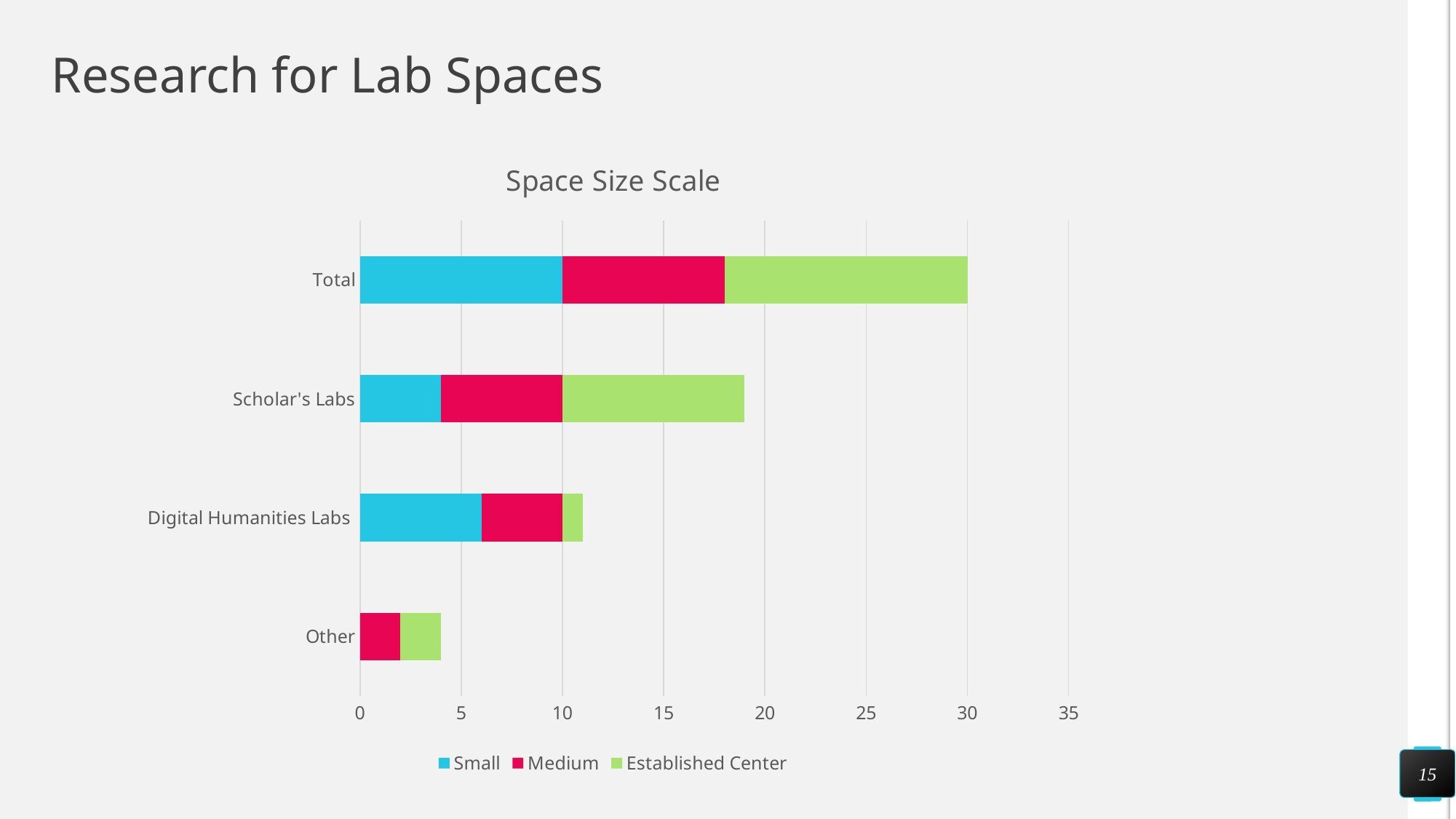
Which category has the shortest stacked bar? Other Which has a longer stacked bar, Scholar's Labs or Digital Humanities Labs? Scholar's Labs How many categories are shown on the chart? 4 What kind of chart is shown on the slide? Stacked bar chart What is the total length of the stacked bar for Total? 30 What is the title of the chart? Space Size Scale Is the total stacked bar for Scholar's Labs greater or less than 15? greater Is the total stacked bar for Other greater or less than 5? less What is the Small value for Total? 10 How many series does the legend list? 3 Which series is shown in green in the legend? Established Center Which category has the longest stacked bar? Total